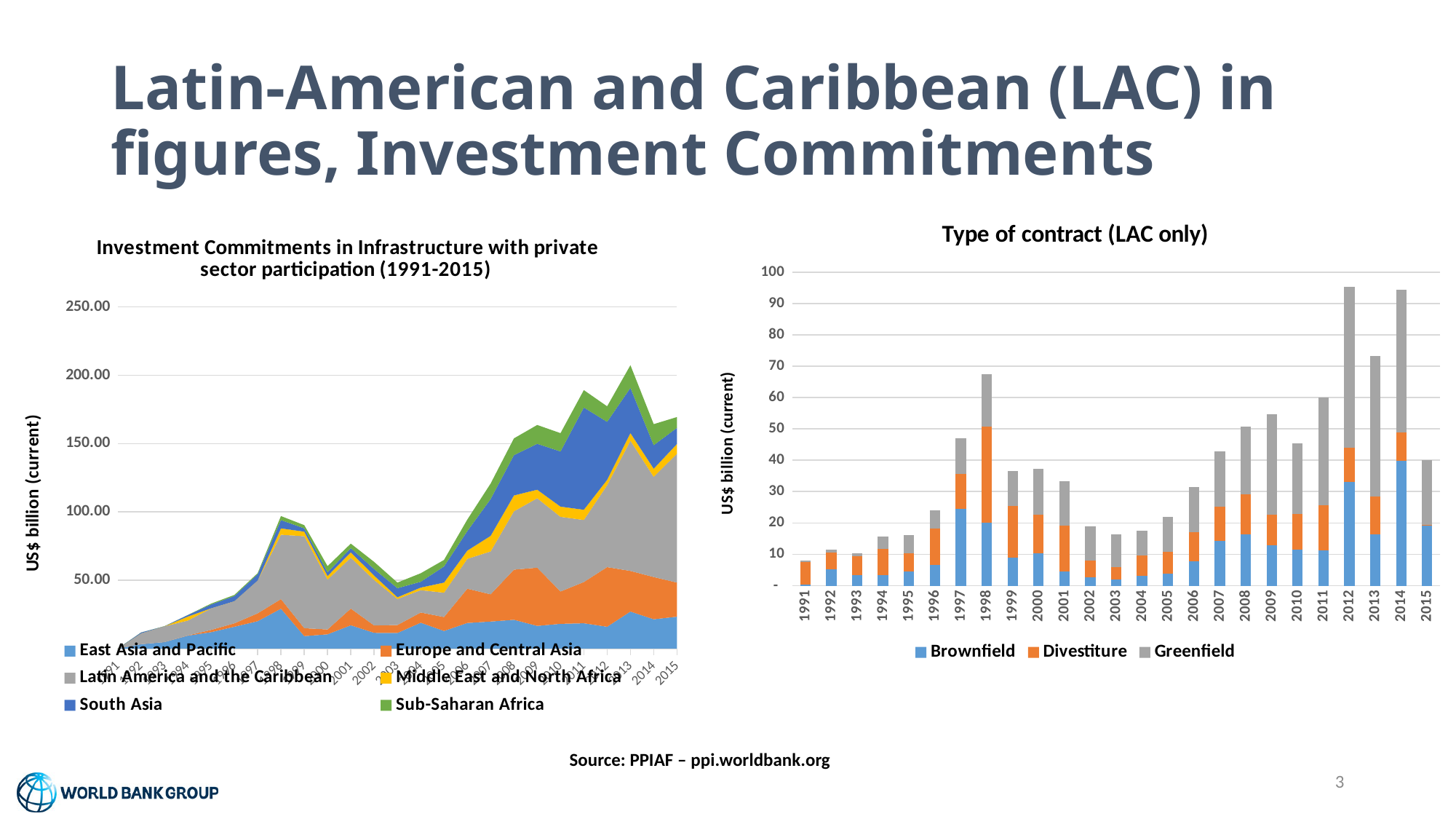
In the 'Type of contract (LAC only)' chart, which year has the taller total bar, 1997 or 1998? 1998 In the 'Investment Commitments in Infrastructure with private sector participation (1991-2015)' chart, is the total for 2013 greater or less than 200.00? greater What kind of chart is the 'Investment Commitments in Infrastructure with private sector participation (1991-2015)' chart? Stacked area chart What is the y-axis label of the 'Type of contract (LAC only)' chart? US$ billion (current) In the 'Type of contract (LAC only)' chart, which series is shown in grey? Greenfield In the 'Type of contract (LAC only)' chart, is the total bar for 2003 greater or less than 20? less How many years are shown on the x axis of the 'Type of contract (LAC only)' chart? 25 What kind of chart is the 'Type of contract (LAC only)' chart? Stacked bar chart In the 'Type of contract (LAC only)' chart, is the total bar for 2012 greater or less than 90? greater How many series does the legend of the 'Type of contract (LAC only)' chart list? 3 How many series does the legend of the 'Investment Commitments in Infrastructure with private sector participation (1991-2015)' chart list? 6